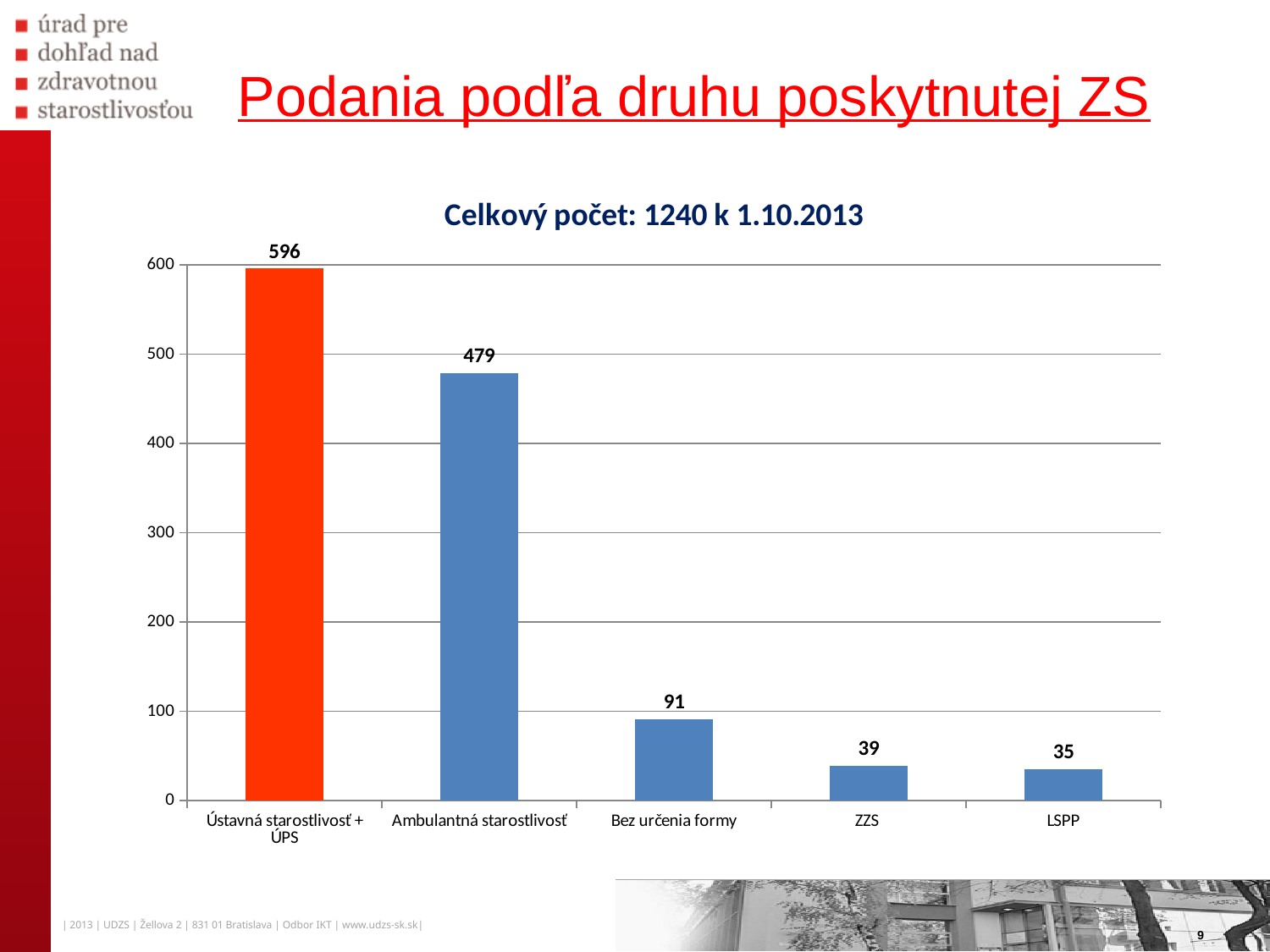
What is the value for ZZS? 39 How many categories are shown in the chart? 5 What is the value for LSPP? 35 What kind of chart is shown on the slide? bar chart What is the difference between Bez určenia formy and ZZS? 52 What is the value for Ambulantná starostlivosť? 479 What is the chart title shown above the bars? Celkový počet: 1240 k 1.10.2013 Which category has the lowest value? LSPP Which category has the highest value? Ústavná starostlivosť + ÚPS What is the difference between Ústavná starostlivosť + ÚPS and Ambulantná starostlivosť? 117 Is the value for Bez určenia formy greater or less than 100? less Which is larger, Bez určenia formy or ZZS? Bez určenia formy